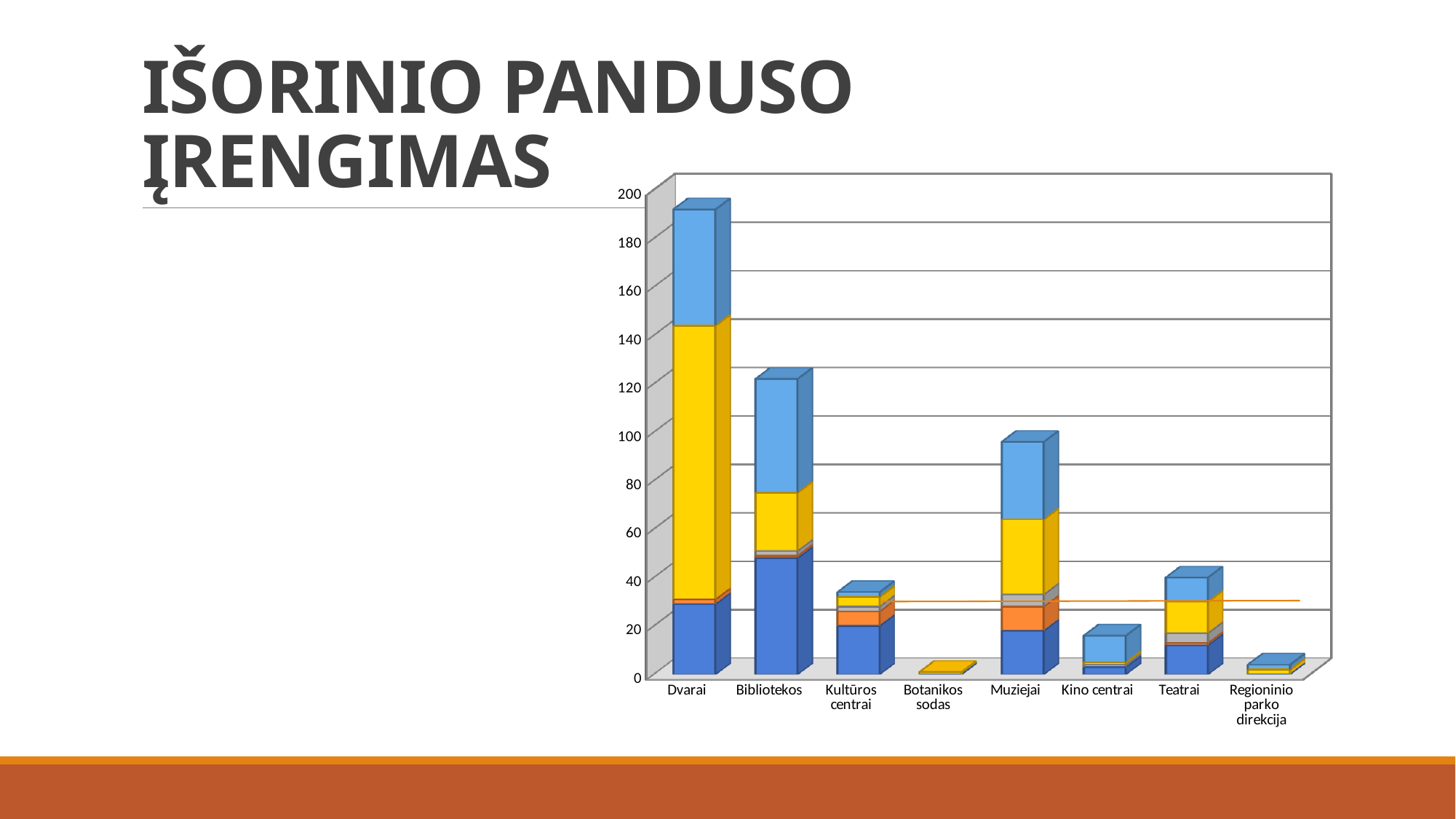
Is the total value for Muziejai greater or less than 80? greater Which category has the tallest stacked bar? Dvarai Is the total value for Kino centrai greater or less than 20? less What is the title of the slide containing the chart? IŠORINIO PANDUSO ĮRENGIMAS Which has the larger total, Teatrai or Kino centrai? Teatrai How many categories are shown on the x axis of the chart? 8 Is the total value for Dvarai greater or less than 180? greater Which category has the shortest stacked bar? Botanikos sodas What kind of chart is shown on the slide? bar chart Which has the larger total, Bibliotekos or Muziejai? Bibliotekos